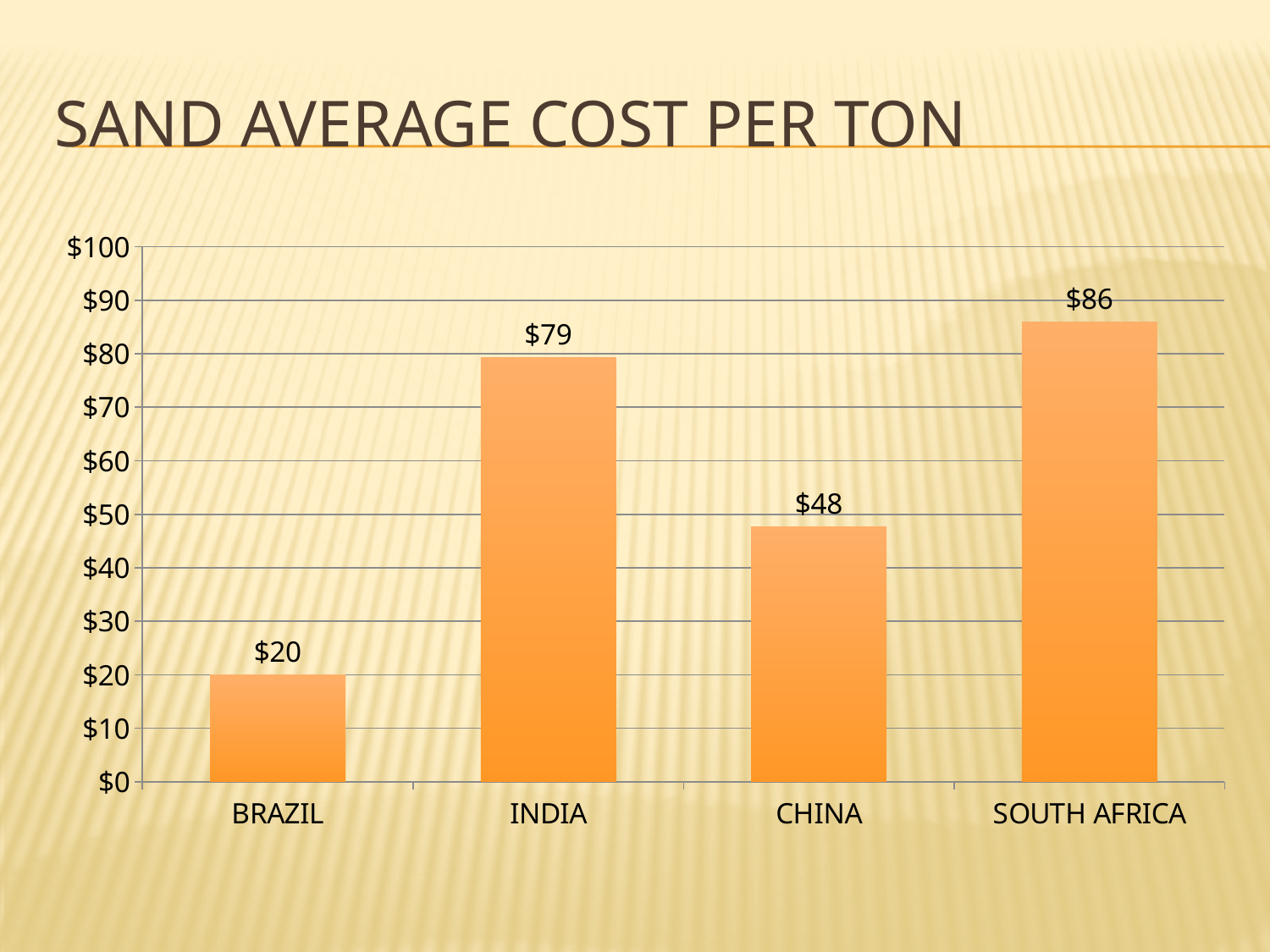
What is the average sand cost per ton for Brazil? $20 What kind of chart is shown on the slide? Bar chart Which country has the highest average sand cost per ton? South Africa Which has a higher average sand cost per ton, India or China? India What is the average sand cost per ton for South Africa? $86 What is the difference between the average sand cost per ton for China and Brazil? $28 How many countries are shown in the chart? 4 What is the difference between the average sand cost per ton for South Africa and India? $7 Is the value for China greater or less than $50? less What is the average sand cost per ton for China? $48 What is the average sand cost per ton for India? $79 Which country has the lowest average sand cost per ton? Brazil